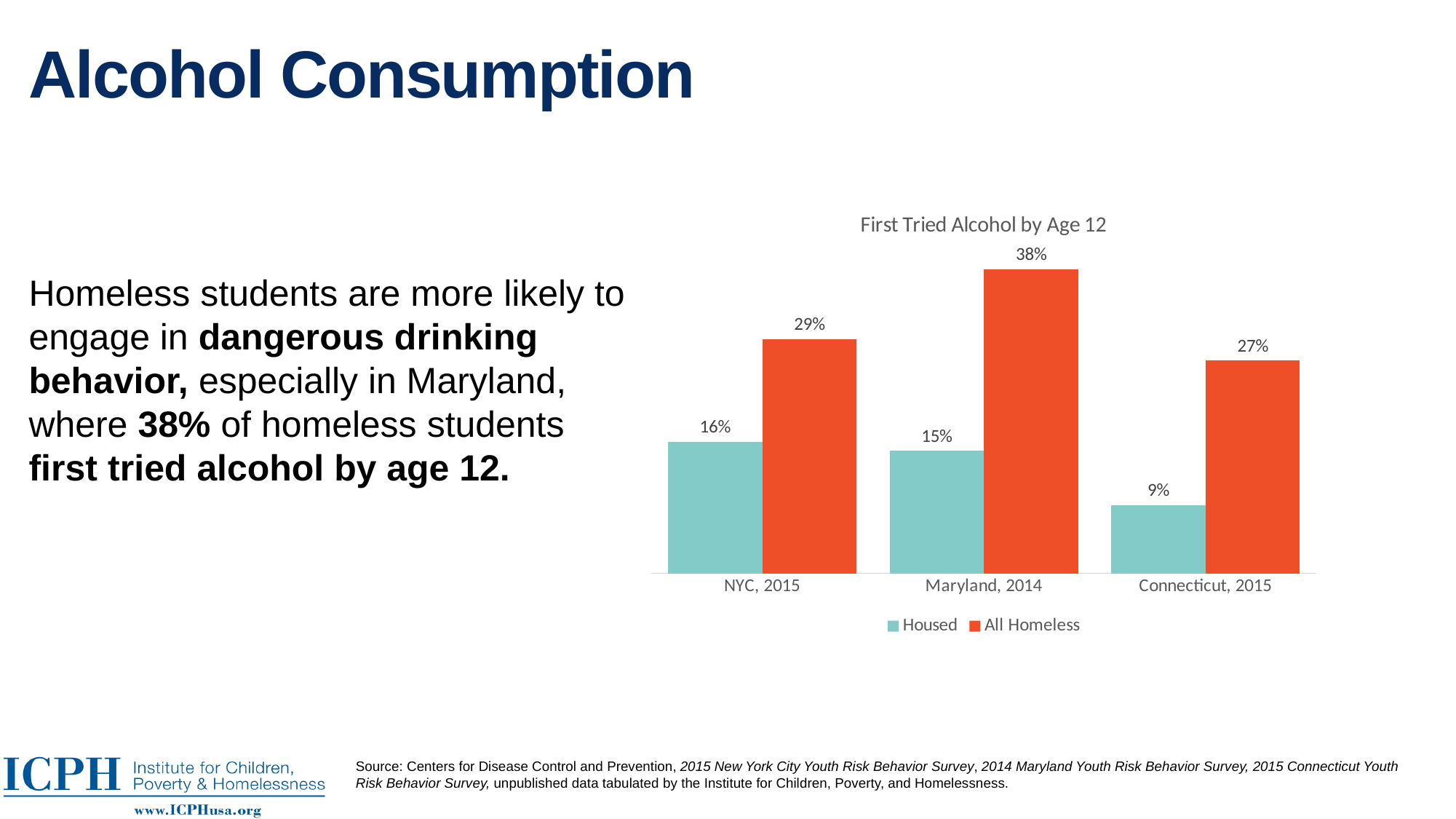
What is the title of the chart? First Tried Alcohol by Age 12 How many series does the legend list? 2 What is the value for Housed in Connecticut, 2015? 9% What kind of chart is shown on the slide? Bar chart Which is larger: the All Homeless value for NYC, 2015 or the All Homeless value for Connecticut, 2015? NYC, 2015 How many categories are shown on the x axis? 3 What is the difference between the All Homeless and Housed values in Maryland, 2014? 23 percentage points What is the value for All Homeless in Maryland, 2014? 38% Which category has the lowest Housed value? Connecticut, 2015 What is the value for Housed in NYC, 2015? 16% What is the value for All Homeless in Connecticut, 2015? 27% Which category has the highest All Homeless value? Maryland, 2014